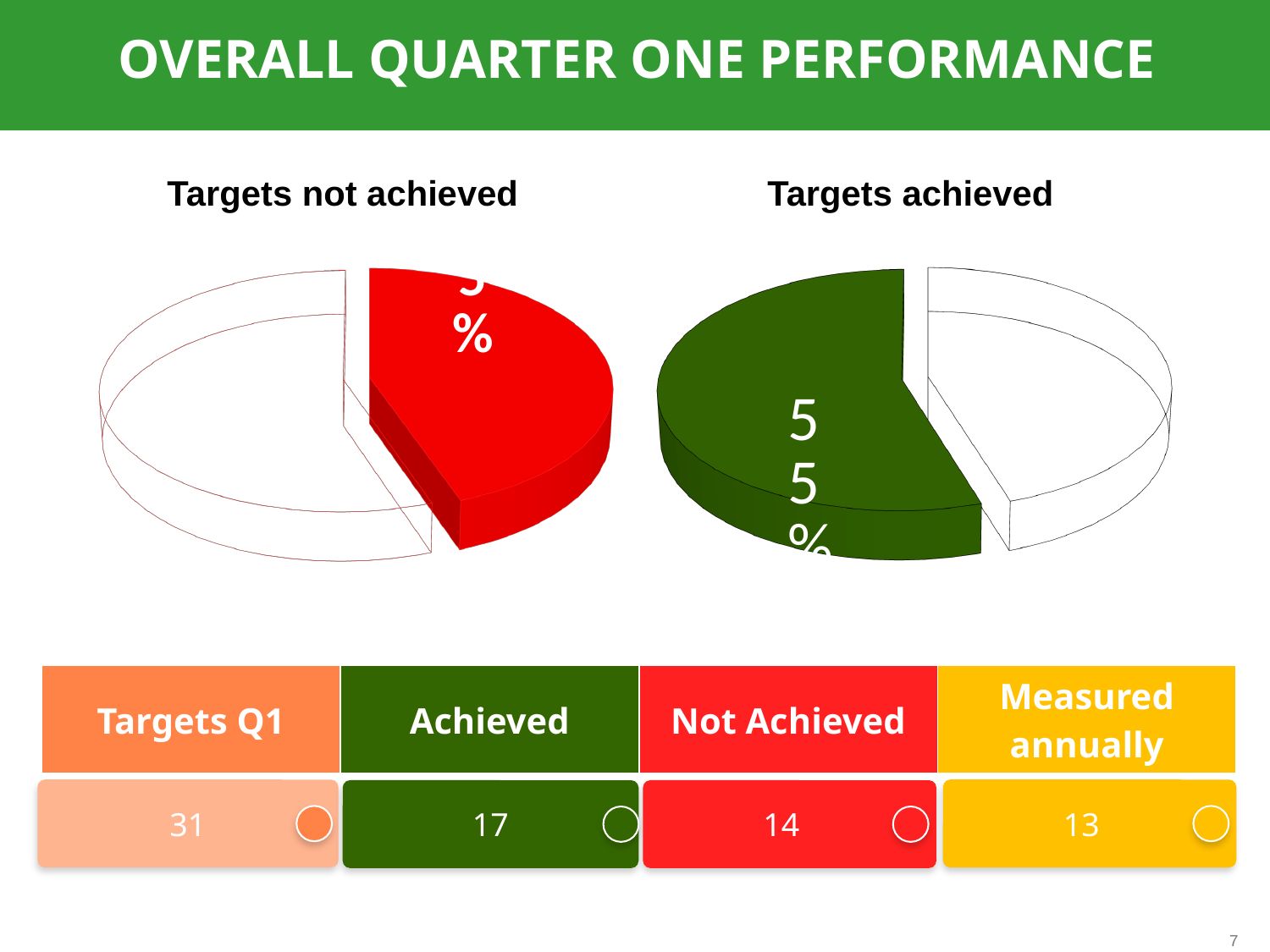
What kind of chart is used for "Targets achieved"? pie chart What kind of chart is used for "Targets not achieved"? pie chart What colour is the highlighted slice in the "Targets not achieved" chart? red In the "Targets achieved" chart, what percentage is printed on the green slice? 55% In the "Targets achieved" chart, what share of the pie does the green slice represent? 55% What colour is the highlighted slice in the "Targets achieved" chart? green Which chart has the larger coloured slice, "Targets achieved" or "Targets not achieved"? Targets achieved